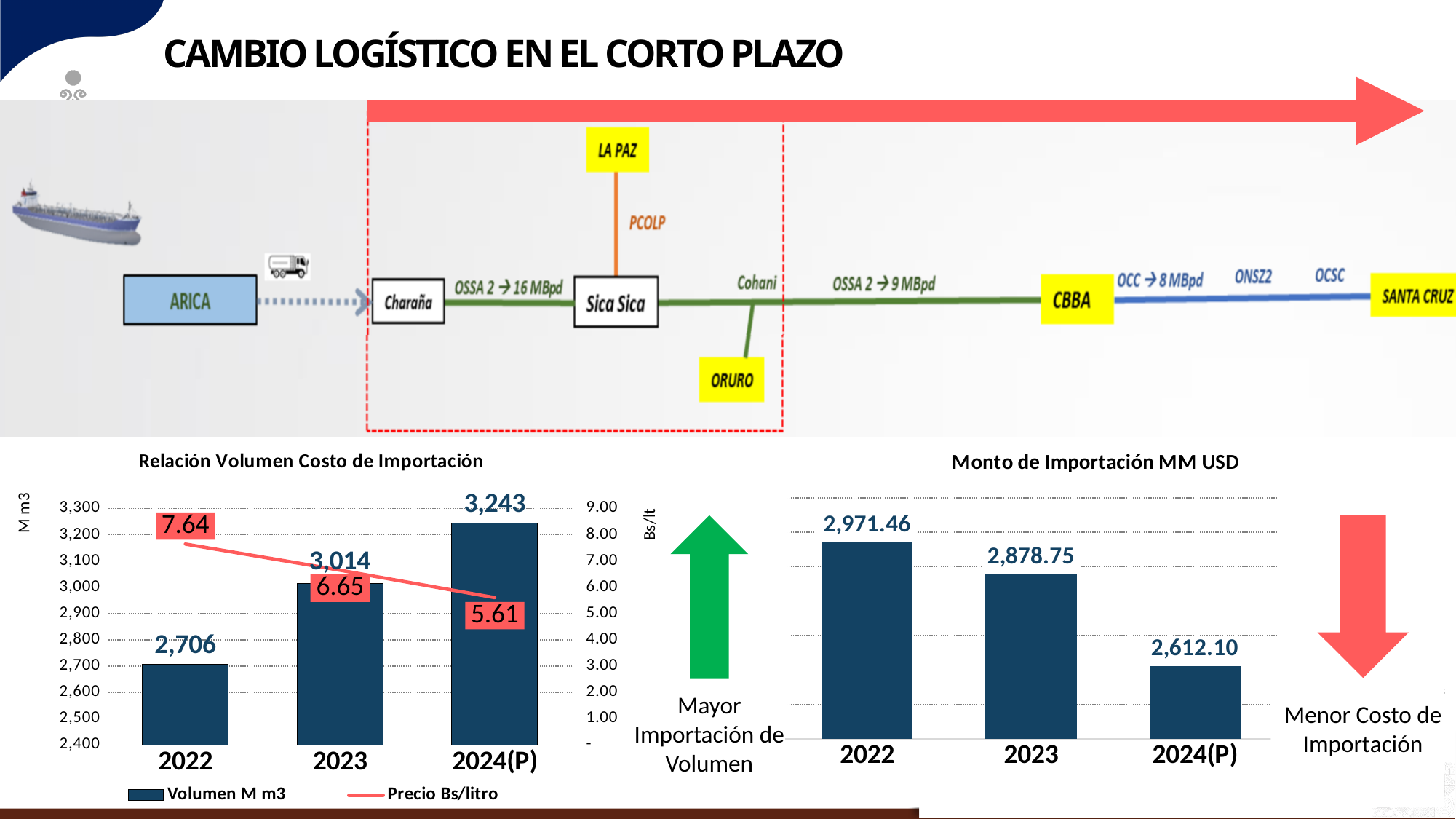
In the chart titled "Relación Volumen Costo de Importación", which year has the lowest Precio Bs/litro? 2024(P) In the chart titled "Monto de Importación MM USD", which year has the lowest value? 2024(P) In the chart titled "Monto de Importación MM USD", what is the difference between the 2022 and 2024(P) values? 359.36 What kind of chart is the chart titled "Monto de Importación MM USD"? bar chart In the chart titled "Relación Volumen Costo de Importación", what is the Precio Bs/litro value for 2024(P)? 5.61 In the chart titled "Relación Volumen Costo de Importación", how many series does the legend list? 2 In the chart titled "Relación Volumen Costo de Importación", which year has the highest Volumen M m3? 2024(P) In the chart titled "Relación Volumen Costo de Importación", does the Precio Bs/litro rise or fall from 2022 to 2024(P)? fall In the chart titled "Relación Volumen Costo de Importación", what is the difference in Volumen M m3 between 2024(P) and 2023? 229 In the chart titled "Relación Volumen Costo de Importación", what is the Volumen M m3 value for 2022? 2,706 In the chart titled "Monto de Importación MM USD", how many years are shown on the x axis? 3 In the chart titled "Monto de Importación MM USD", what is the value for 2023? 2,878.75